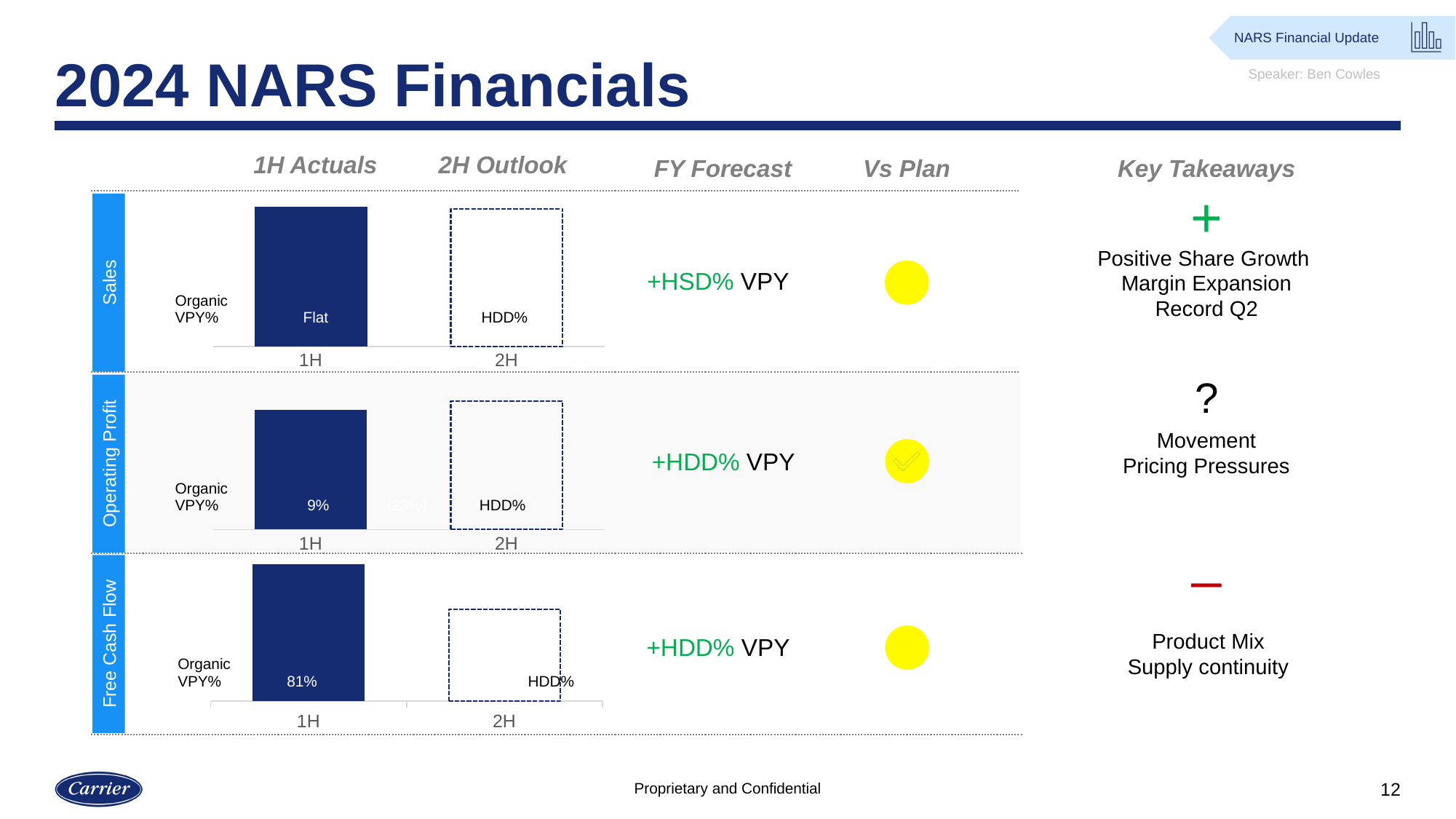
What metric is plotted in each of the three charts, according to the label to the left of the bars? Organic VPY% In the Operating Profit chart, what is the data label on the 2H bar? HDD% In the Free Cash Flow chart, what is the data label on the 2H bar? HDD% In the Free Cash Flow chart, what is the data label on the 1H bar? 81% How many bars are shown in the Free Cash Flow chart? 2 In the Sales chart, what is the data label on the 2H bar? HDD% In the Operating Profit chart, what is the data label on the 1H bar? 9% In the Sales chart, which bar is drawn as a dashed outline rather than a solid fill? 2H What kind of chart is used in the Sales row? Bar chart What are the two x-axis categories in the Operating Profit chart? 1H and 2H In the Sales chart, what is the data label on the 1H bar? Flat How many separate bar charts are shown on the slide? 3